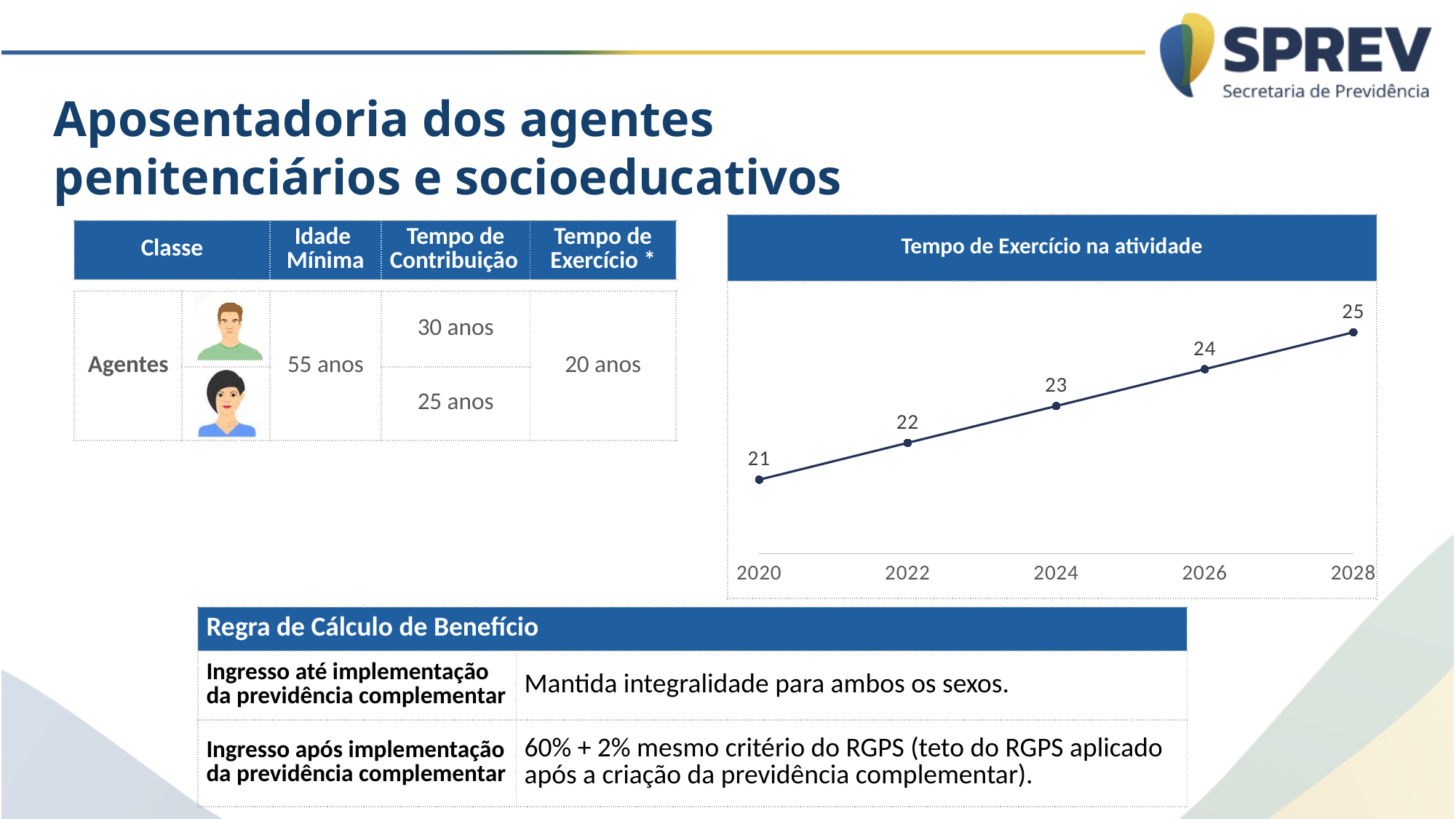
Which year has the lowest value in the chart? 2020 What is the difference between the values for 2028 and 2020? 4 How many data points are plotted in the chart? 5 What kind of chart is shown on the slide? line chart What is the title of the chart on the slide? Tempo de Exercício na atividade What is the value for 2020 in the chart? 21 What is the value for 2028 in the chart? 25 What is the difference between the values for 2026 and 2022? 2 What is the value for 2024 in the chart? 23 Which is larger, the value for 2022 or the value for 2026? 2026 Which year has the highest value in the chart? 2028 Do the values rise or fall from 2020 to 2028? rise